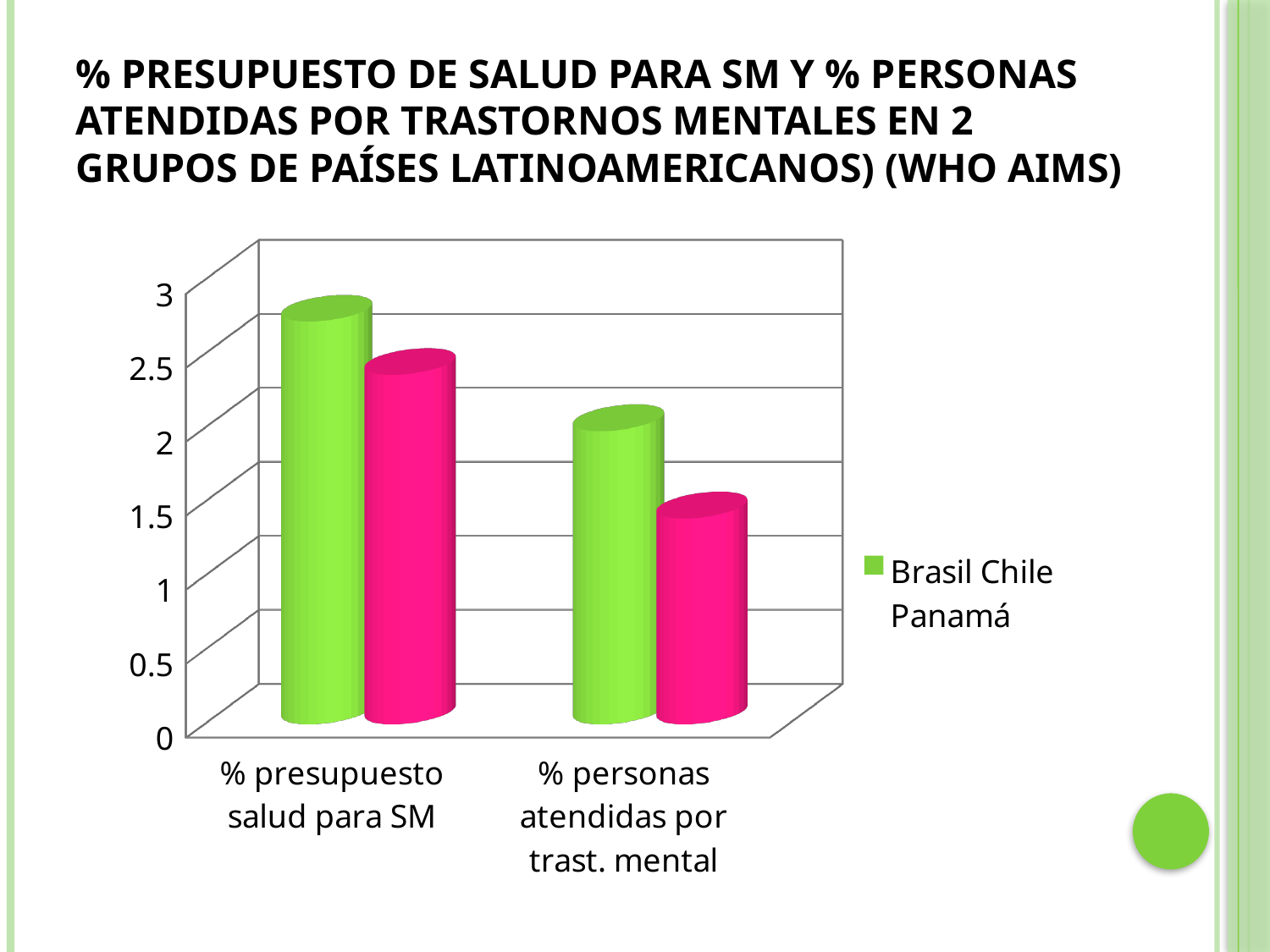
What kind of chart is shown on the slide? bar chart How many series does the chart's legend list? 1 Is the Brasil Chile Panamá value for % personas atendidas por trast. mental greater or less than 2.5? less What colour are the bars for the Brasil Chile Panamá series? green For the Brasil Chile Panamá series, do the values rise or fall from % presupuesto salud para SM to % personas atendidas por trast. mental? fall For the Brasil Chile Panamá series, which category has the highest value? % presupuesto salud para SM For the Brasil Chile Panamá series, which category has the lowest value? % personas atendidas por trast. mental For the Brasil Chile Panamá series, which is larger: the value for % presupuesto salud para SM or the value for % personas atendidas por trast. mental? % presupuesto salud para SM Is the Brasil Chile Panamá value for % presupuesto salud para SM greater or less than 2.5? greater How many categories are shown on the x axis of the chart? 2 What is the series name shown in the chart's legend? Brasil Chile Panamá Is the Brasil Chile Panamá value for % personas atendidas por trast. mental greater or less than 1.5? greater